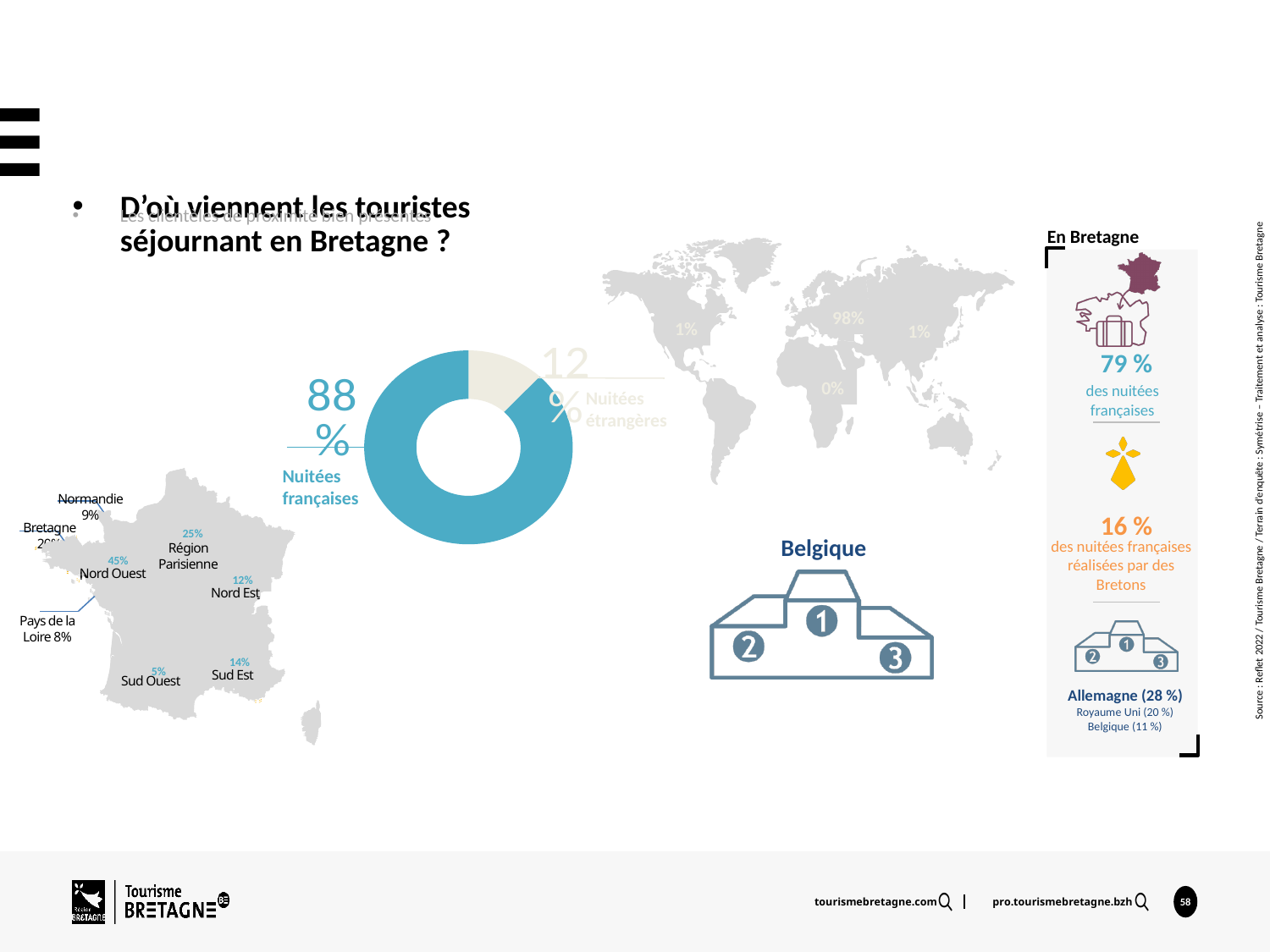
How many slices does the donut chart have? 2 What kind of chart shows the split between French and foreign nights? Donut (pie) chart On the map of France, which region has the lowest percentage shown? Sud Ouest In the donut chart, what share of nights is foreign (Nuitées étrangères)? 12% In the donut chart, is the share of Nuitées étrangères greater or less than 50%? less In the donut chart, which category has the largest share? Nuitées françaises In the donut chart, what is the difference in percentage points between Nuitées françaises and Nuitées étrangères? 76 percentage points In the donut chart, which category has the smallest share? Nuitées étrangères In the donut chart, what colour is the Nuitées françaises slice? Blue On the map of France, what percentage is shown for Nord Ouest? 45% In the donut chart, what share of nights (nuitées) is French (Nuitées françaises)? 88% In the donut chart, which is larger: Nuitées françaises or Nuitées étrangères? Nuitées françaises